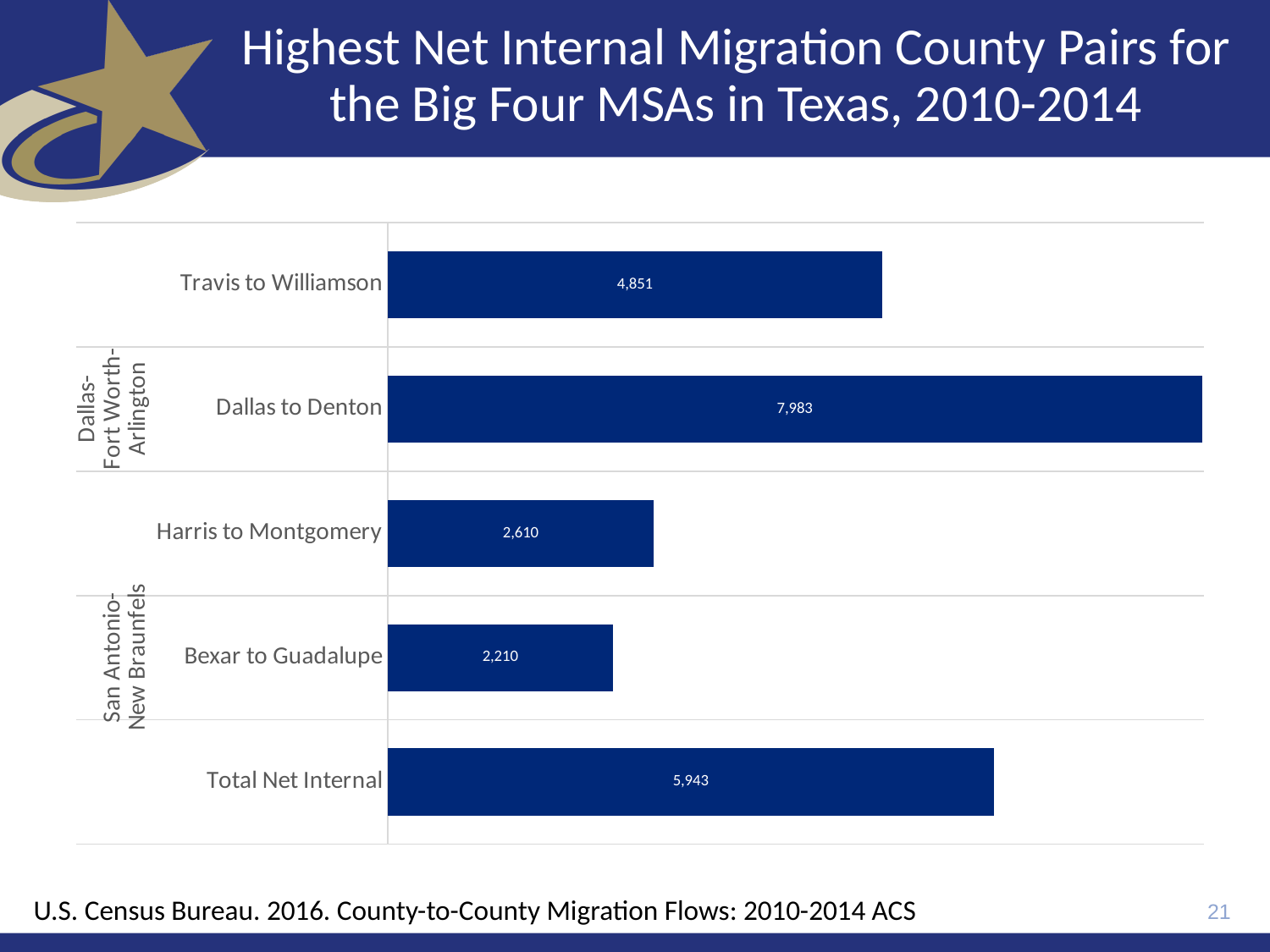
What is the difference between Dallas to Denton and Travis to Williamson? 3,132 What is the value for Bexar to Guadalupe? 2,210 What is the difference between Harris to Montgomery and Bexar to Guadalupe? 400 What kind of chart is shown on the slide? Bar chart What is the value for Total Net Internal? 5,943 What is the value for Harris to Montgomery? 2,610 Which is larger, Total Net Internal or Travis to Williamson? Total Net Internal Which county pair has the highest net internal migration? Dallas to Denton Which category has the lowest value? Bexar to Guadalupe How many bars are shown in the chart? 5 What is the value for Travis to Williamson? 4,851 What is the value for Dallas to Denton? 7,983